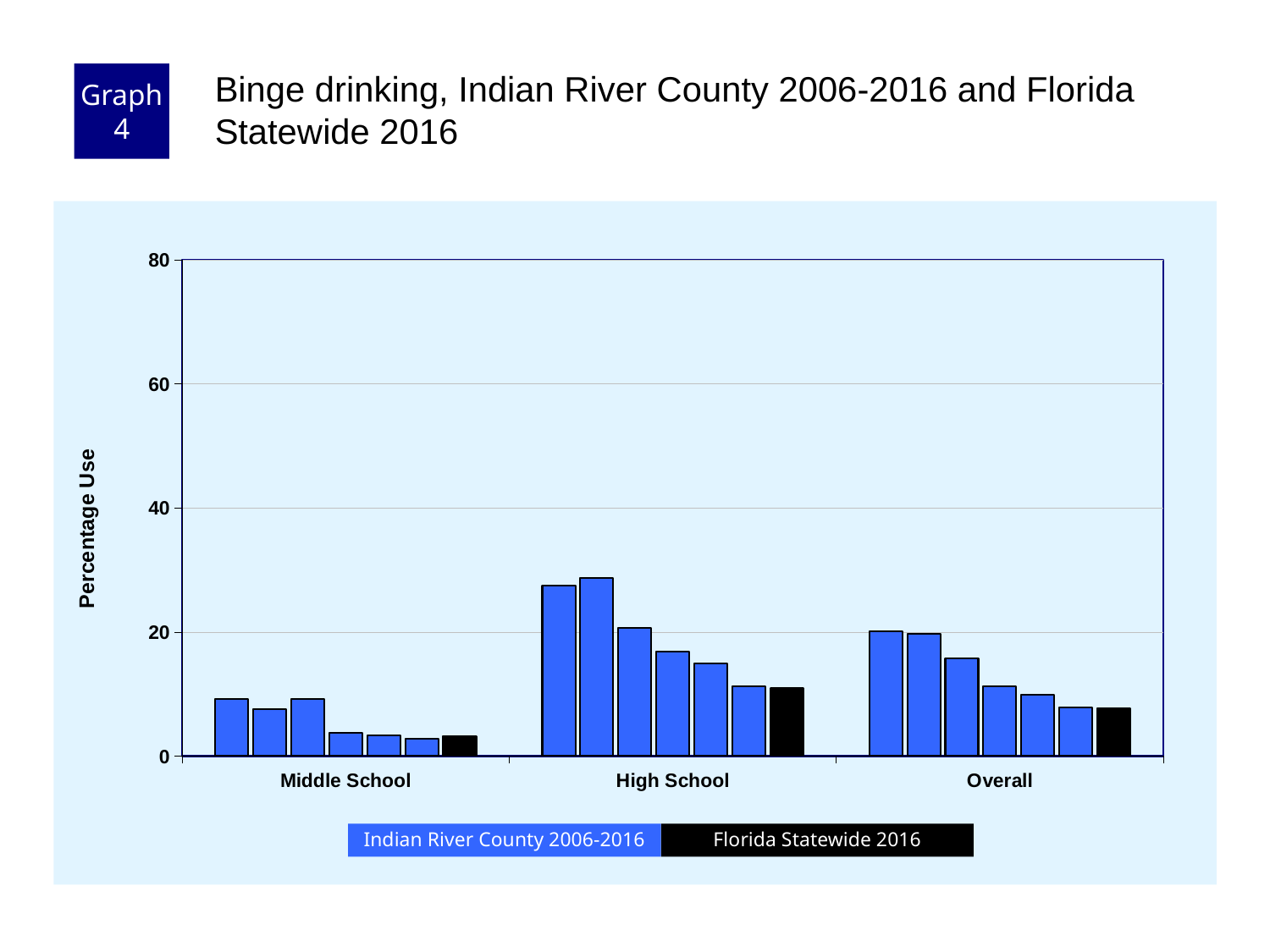
Which category has the tallest bars? High School How many categories are shown on the x axis? 3 Which category has the shortest bars? Middle School What kind of chart is shown on the slide? bar chart What colour are the Florida Statewide 2016 bars? black In the Overall group, do the Indian River County 2006-2016 bars rise or fall from left to right? fall How many series does the legend list? 2 Is the Florida Statewide 2016 value for Overall greater or less than 20? less Is the Florida Statewide 2016 value for Middle School greater or less than 20? less What is the label on the y axis? Percentage Use Is the tallest Indian River County 2006-2016 bar for High School greater or less than 20? greater Which is larger, the Florida Statewide 2016 value for High School or for Overall? High School